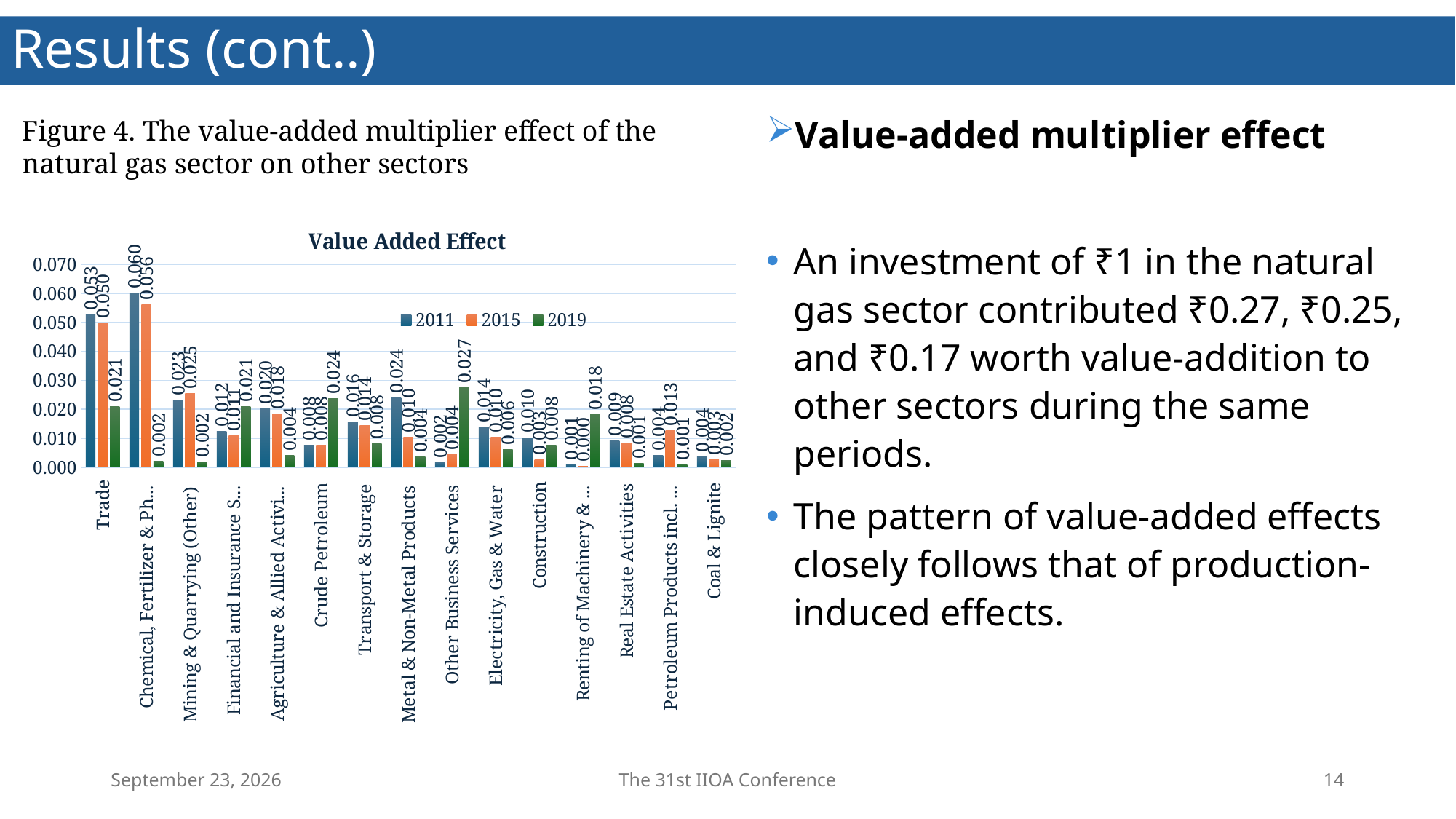
Which sector has the highest 2011 value in the Value Added Effect chart? Chemical, Fertilizer & Ph... How many sectors (categories) are shown on the x axis of the Value Added Effect chart? 15 How many series does the legend of the Value Added Effect chart list? 3 Which sector has the highest 2019 value in the Value Added Effect chart? Other Business Services What is the title of the chart on the slide? Value Added Effect What is the difference between the 2011 and 2019 values for Trade? 0.032 What is the 2019 value for Renting of Machinery & ...? 0.018 What is the 2019 value for Other Business Services? 0.027 Which is larger for Crude Petroleum: the 2011 value or the 2019 value? 2019 What is the 2015 value for Mining & Quarrying (Other)? 0.025 What is the 2011 value for Trade in the Value Added Effect chart? 0.053 What type of chart is shown on the slide? bar chart